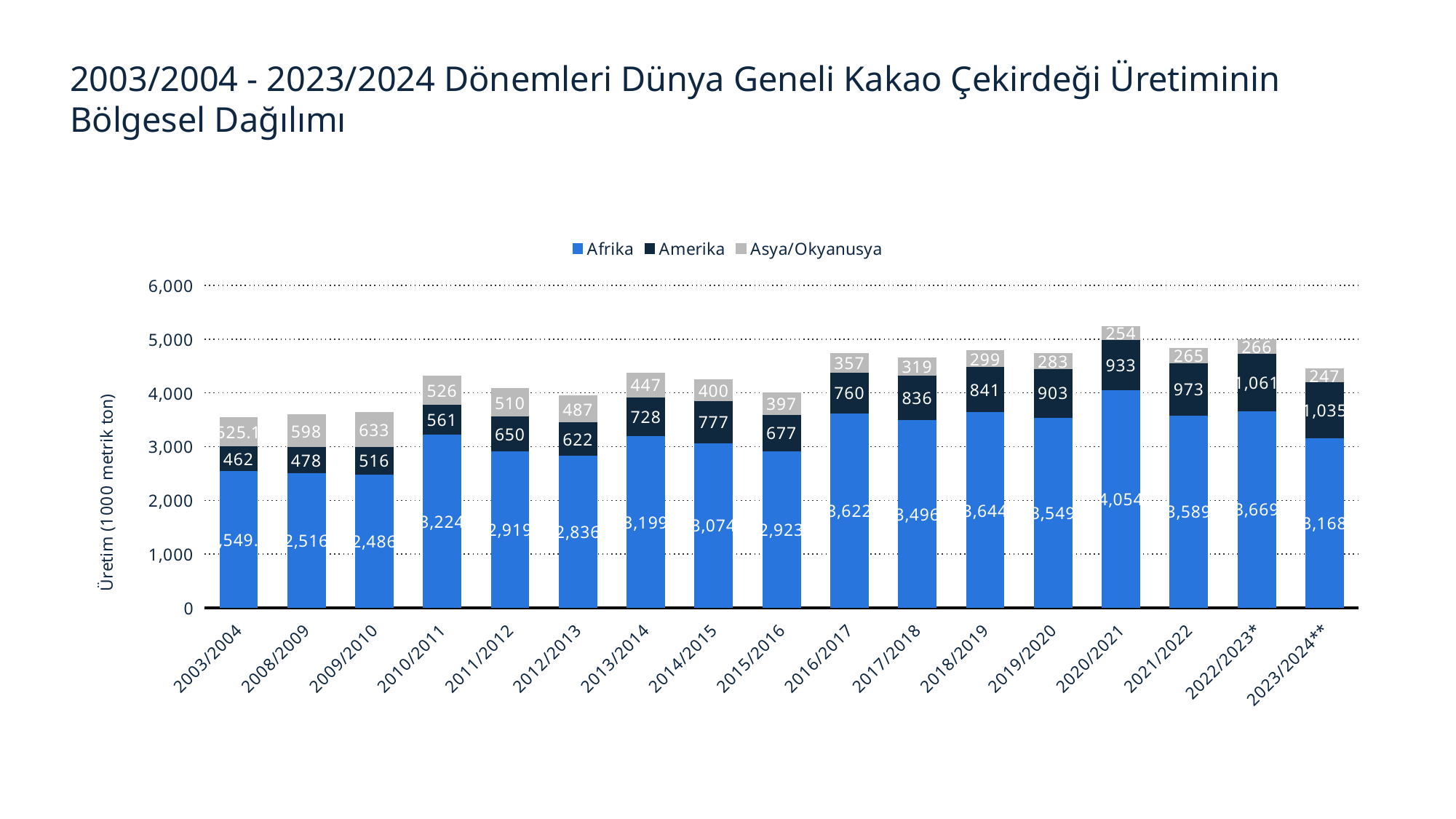
How many series does the legend list? 3 What is the total of the stacked bar for 2020/2021? 5,241 In which period is the Asya/Okyanusya value lowest? 2023/2024** Which is larger, the Afrika value for 2016/2017 or for 2018/2019? 2018/2019 In which period is the Afrika value highest? 2020/2021 How many periods are shown on the x axis? 17 What is the difference between the Amerika values for 2022/2023* and 2023/2024**? 26 What is the Asya/Okyanusya value for 2009/2010? 633 What kind of chart is shown on the slide? Stacked bar chart What is the Afrika value for 2020/2021? 4,054 Is the total of the stacked bar for 2010/2011 greater or less than 4,000? greater What is the Amerika value for 2022/2023*? 1,061